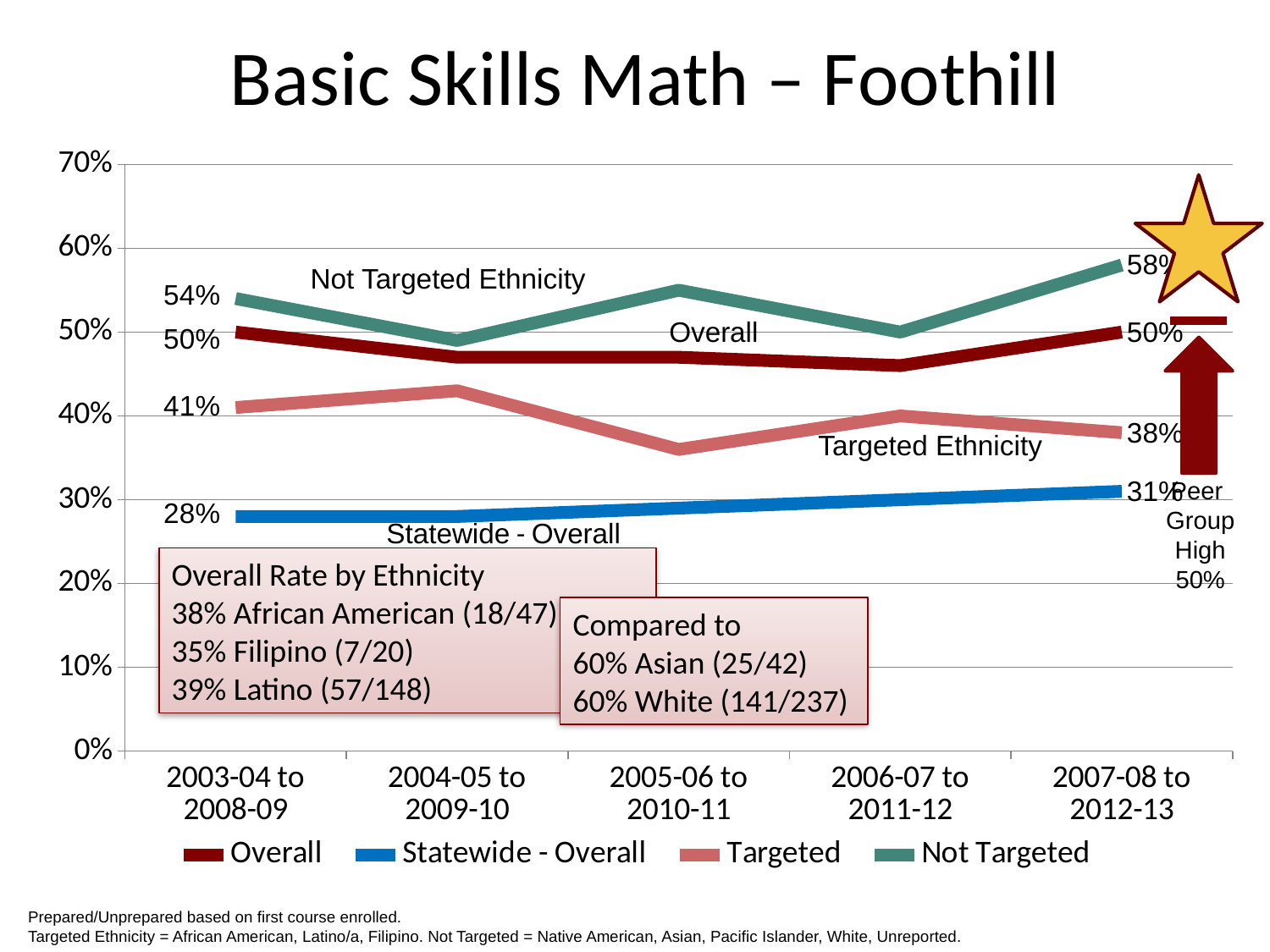
What is the Targeted value for 2007-08 to 2012-13? 38% Which is larger in 2003-04 to 2008-09, the Overall value or the Targeted value? Overall What is the Not Targeted value for 2003-04 to 2008-09? 54% What is the difference between the Not Targeted and Targeted values for 2007-08 to 2012-13? 20% Does the Statewide - Overall series rise or fall from 2003-04 to 2008-09 to 2007-08 to 2012-13? rise How many series does the legend list? 4 What kind of chart is shown on the slide? line chart How many periods are shown on the x axis? 5 Which series has the lowest value in 2007-08 to 2012-13? Statewide - Overall What is the Not Targeted value for 2007-08 to 2012-13? 58% What is the Statewide - Overall value for 2003-04 to 2008-09? 28% Is the Targeted value for 2005-06 to 2010-11 greater or less than 40%? less